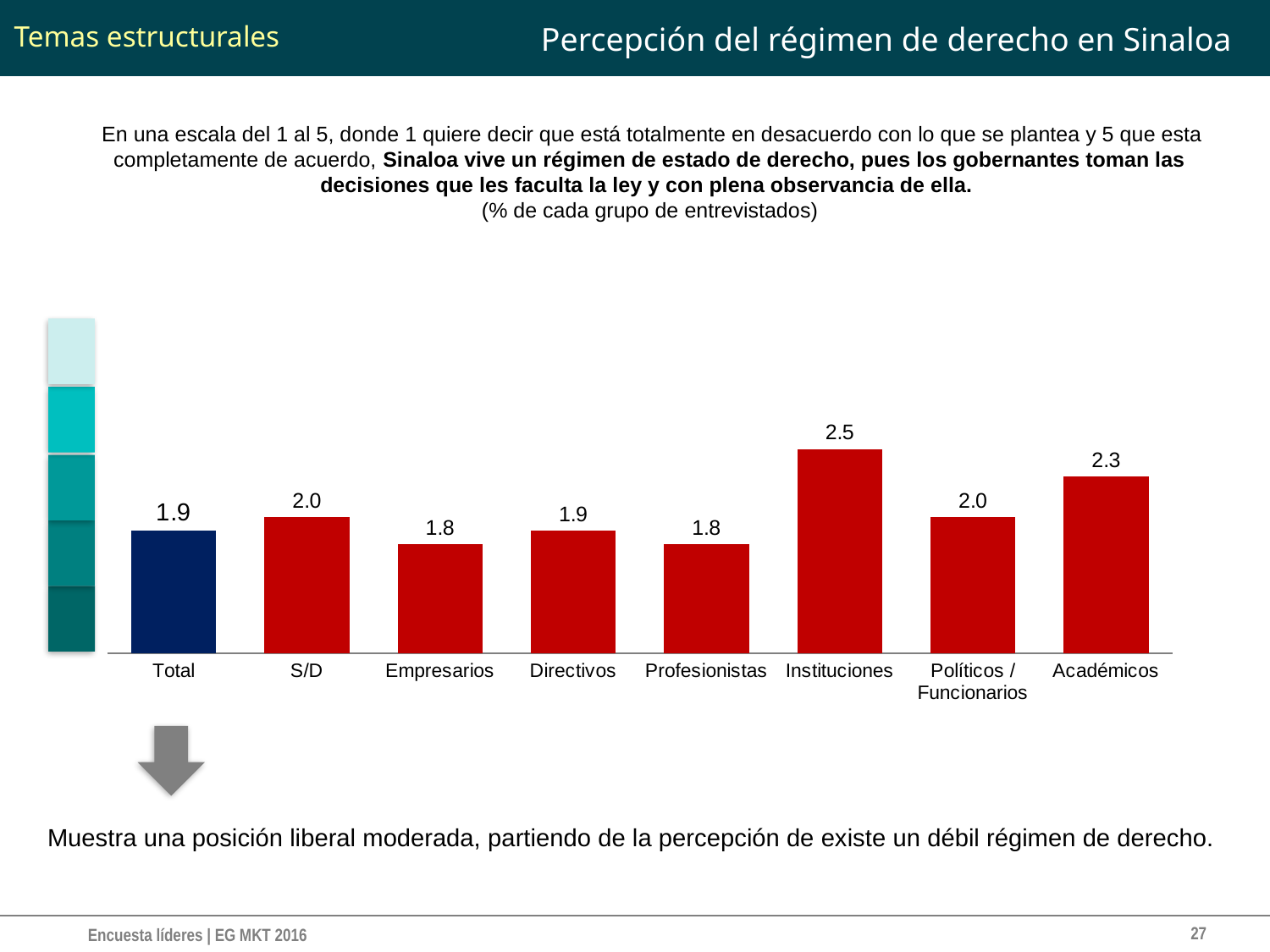
Which category has the highest value? Instituciones Which is larger, the value for Académicos or the value for S/D? Académicos What is the value for Total? 1.9 What is the value for Instituciones? 2.5 What is the difference between the values for Instituciones and Total? 0.6 Which is larger, the value for Instituciones or the value for Directivos? Instituciones What is the difference between the values for Académicos and Profesionistas? 0.5 What kind of chart is shown on the slide? Bar chart What is the value for Políticos / Funcionarios? 2.0 What is the value for Académicos? 2.3 How many categories are shown on the x axis? 8 What is the value for Empresarios? 1.8